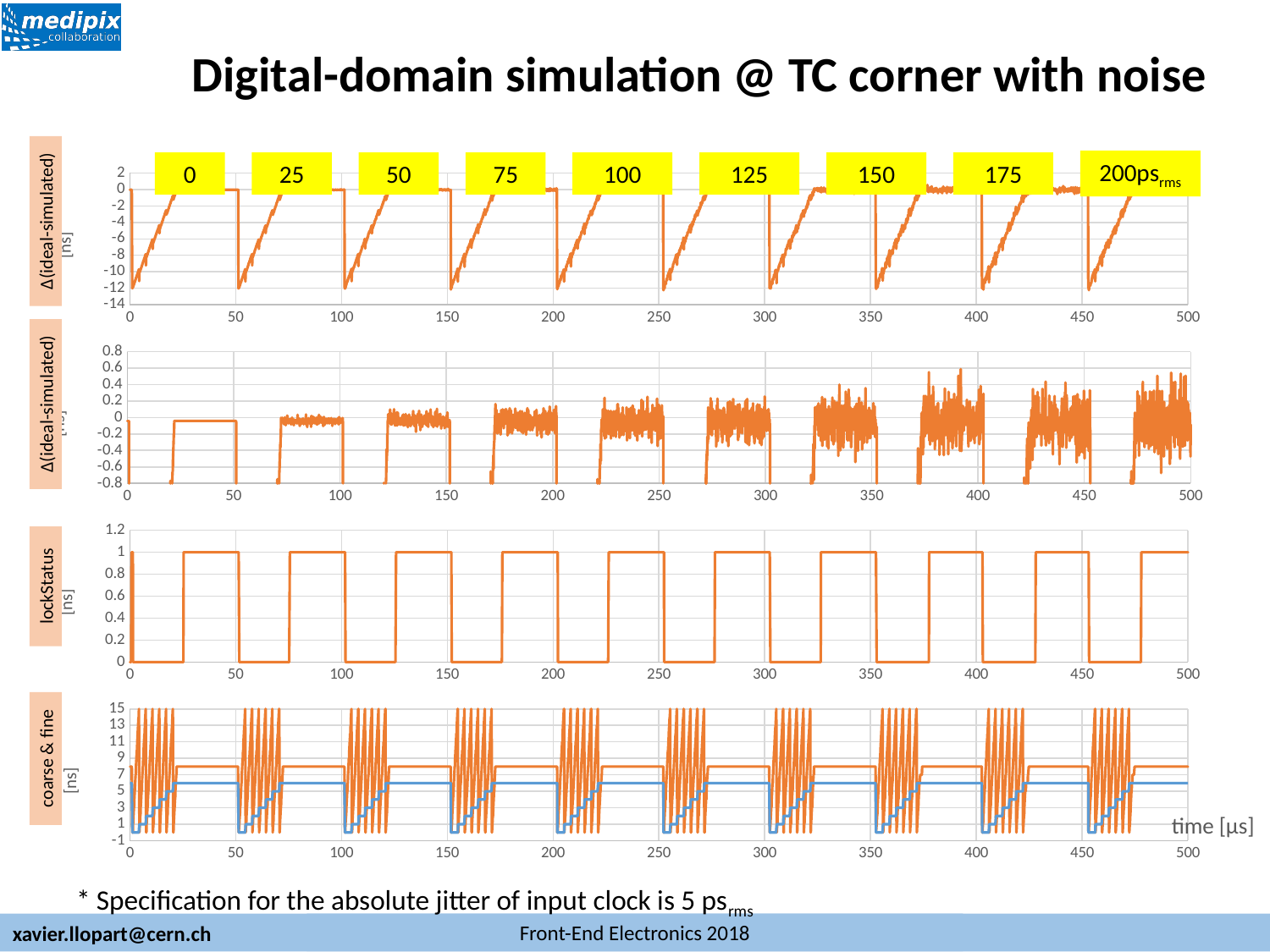
What is the x-axis label shown at the bottom right of the charts? time [µs] How many separate chart panels are stacked on the slide? 4 In the coarse & fine chart, is the flat level of the orange line greater or less than 5? greater What kind of chart is used for the lockStatus panel on the slide? line chart How many yellow noise-level labels (0 through 200ps rms) are shown above the top chart? 9 In the top Δ(ideal-simulated) chart, is the lowest point of each sawtooth greater or less than -10? less In the coarse & fine chart, is the flat level of the blue line greater or less than 3? greater In the lockStatus chart, what is the low level of the signal? 0 What is the maximum value shown on the x axis of the charts? 500 In the second Δ(ideal-simulated) chart, does the noise amplitude of the signal increase or decrease along the x axis? increase In the coarse & fine chart, how many differently coloured lines are plotted? 2 In the lockStatus chart, what is the high level that the signal reaches? 1